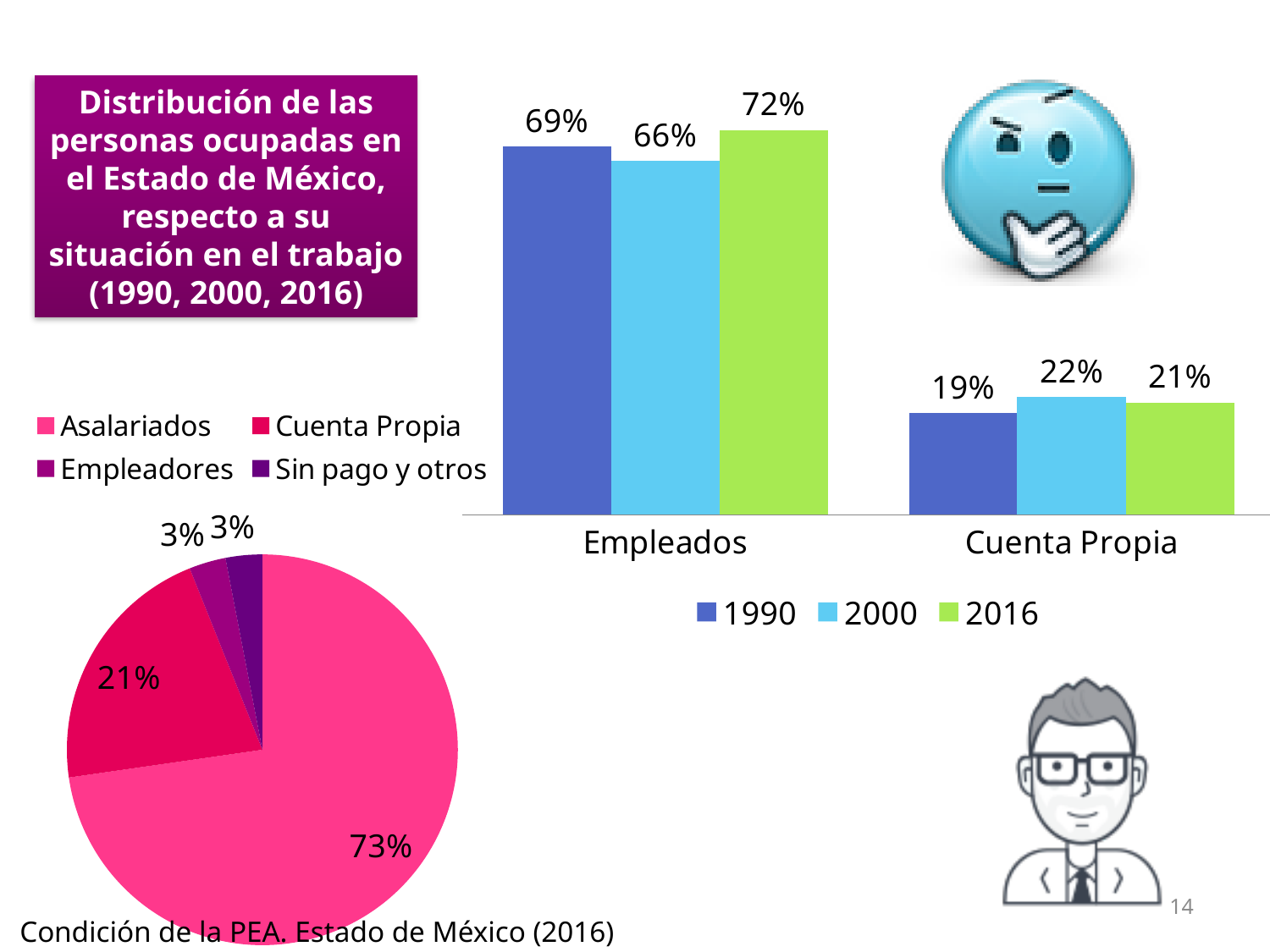
In the bar chart on the right, is the Cuenta Propia value larger in 2000 or in 2016? 2000 How many slices does the pie chart on the bottom left have? 4 How many series does the legend of the bar chart on the right list? 3 In the pie chart on the bottom left, what share does Asalariados have? 73% In the bar chart on the right, what is the difference between the Empleados values for 2016 and 2000? 6% In the bar chart on the right, which year has the highest value for Empleados? 2016 In the bar chart on the right, what is the value for Cuenta Propia in 1990? 19% In the bar chart on the right, which year has the lowest value for Cuenta Propia? 1990 In the bar chart on the right, what is the value for Empleados in 2000? 66% What kind of chart is the chart in the bottom left of the slide? Pie chart In the bar chart on the right, what is the value for Empleados in 2016? 72% In the pie chart on the bottom left, what share does Cuenta Propia have? 21%